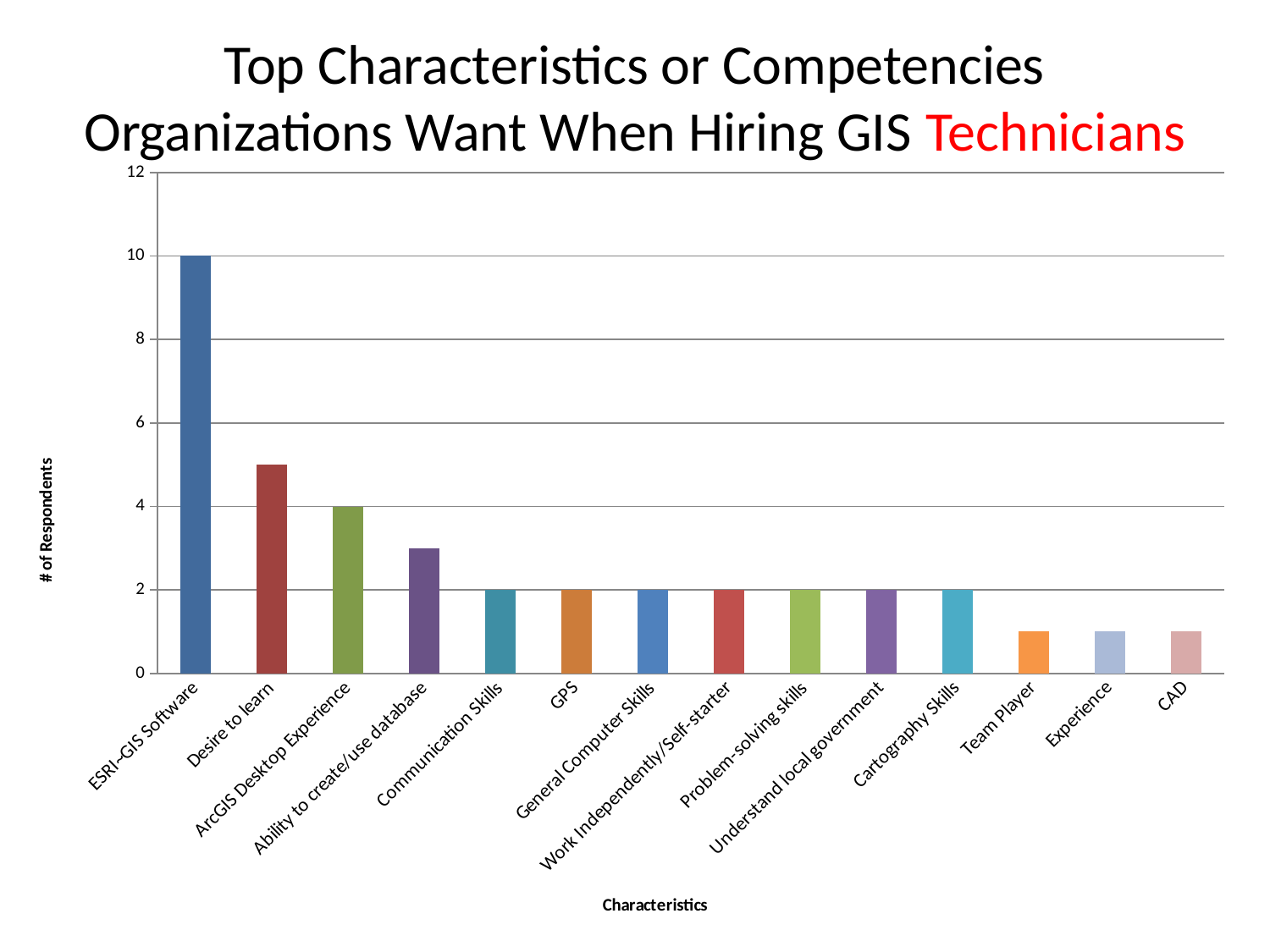
What kind of chart is shown on the slide? bar chart Which characteristic has the highest number of respondents? ESRI~GIS Software Which has more respondents, Desire to learn or Cartography Skills? Desire to learn What is the title of the vertical axis? # of Respondents What is the number of respondents for ArcGIS Desktop Experience? 4 How many characteristics are plotted on the chart? 14 Is the value for Team Player greater or less than 2? less What is the difference in respondents between ESRI-GIS Software and ArcGIS Desktop Experience? 6 Is the value for Desire to learn greater or less than 4? greater What is the number of respondents for ESRI-GIS Software? 10 Do the values rise or fall moving from left to right along the x axis? fall What is the number of respondents for Communication Skills? 2